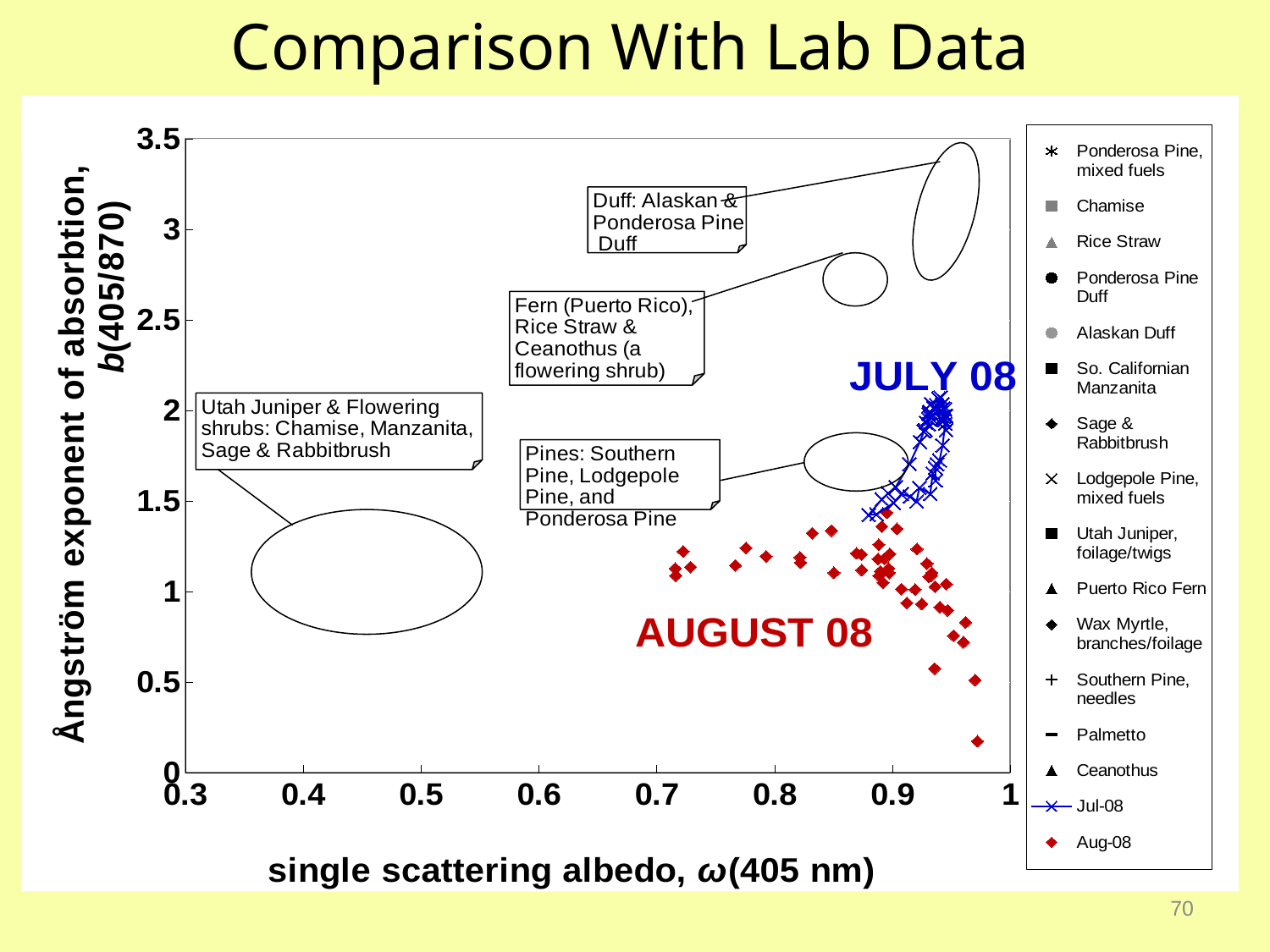
What is the minimum value shown on the x axis? 0.3 What is the title of the slide's chart? Comparison With Lab Data Are the single scattering albedo values of the Aug-08 points greater or less than 0.6? greater How many entries does the legend list? 16 Which series has higher Ångström exponent values overall, Jul-08 or Aug-08? Jul-08 Is the lowest Aug-08 point's Ångström exponent greater or less than 0.5? less What is the maximum value shown on the y axis? 3.5 Is the highest Aug-08 point's Ångström exponent greater or less than 1.5? less What is the label of the x axis? single scattering albedo, ω(405 nm) Do the Aug-08 points' Ångström exponent values rise or fall as single scattering albedo approaches 1? fall What kind of chart is shown on the slide? scatter plot